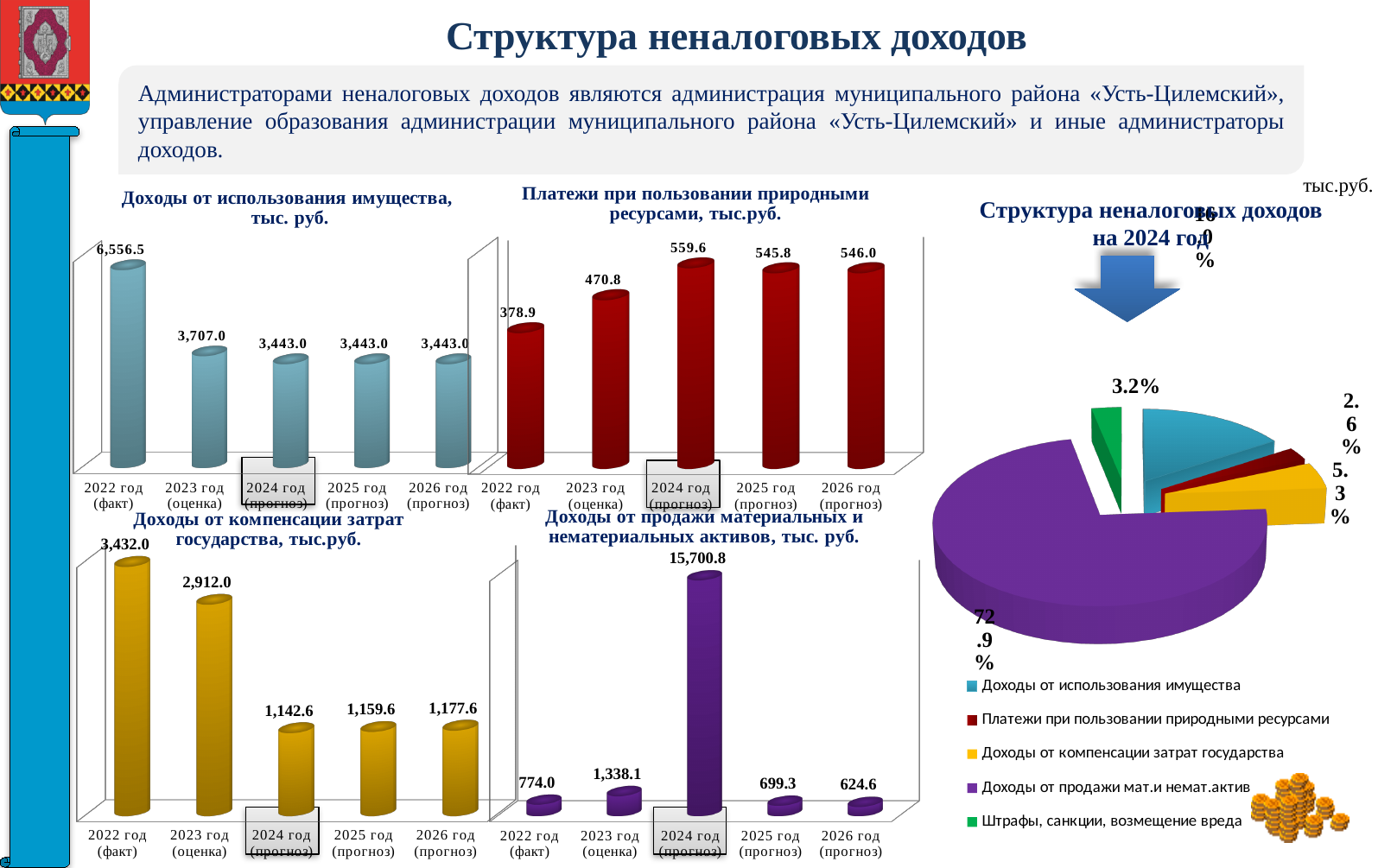
In the chart 'Доходы от продажи материальных и нематериальных активов, тыс. руб.', which year has the lowest value? 2026 год (прогноз) In the chart 'Доходы от использования имущества, тыс. руб.', which year has the highest value? 2022 год (факт) How many entries does the legend of the pie chart 'Структура неналоговых доходов на 2024 год' list? 5 In the chart 'Платежи при пользовании природными ресурсами, тыс.руб.', what is the difference between the 2023 год (оценка) and 2022 год (факт) values? 91.9 In the chart 'Доходы от продажи материальных и нематериальных активов, тыс. руб.', what is the value for 2024 год (прогноз)? 15,700.8 How many year categories are shown in the chart 'Доходы от использования имущества, тыс. руб.'? 5 In the chart 'Доходы от использования имущества, тыс. руб.', what is the value for 2022 год (факт)? 6,556.5 What type of chart is 'Структура неналоговых доходов на 2024 год'? pie chart In the chart 'Доходы от компенсации затрат государства, тыс.руб.', what is the value for 2023 год (оценка)? 2,912.0 In the chart 'Платежи при пользовании природными ресурсами, тыс.руб.', which year has the lowest value? 2022 год (факт) In the chart 'Доходы от компенсации затрат государства, тыс.руб.', which is larger: the value for 2022 год (факт) or 2026 год (прогноз)? 2022 год (факт) In the chart 'Платежи при пользовании природными ресурсами, тыс.руб.', what is the value for 2024 год (прогноз)? 559.6